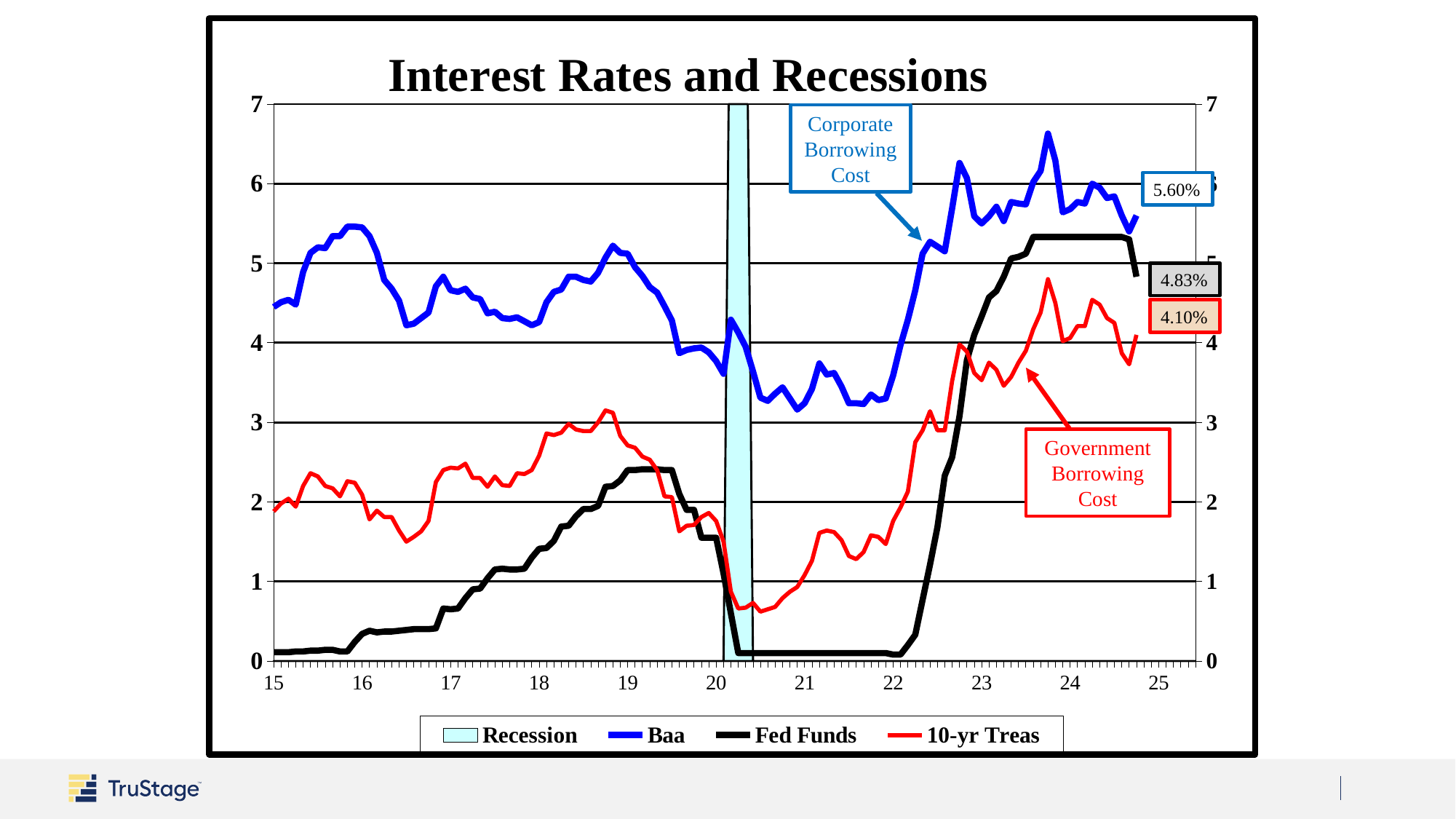
What is the title of the chart? Interest Rates and Recessions Is the Fed Funds value during 2021 greater or less than 1? less How many entries does the legend list? 4 Does the Fed Funds line rise or fall between 2022 and 2023? rise Which series has the lowest labelled value at the end of the chart? 10-yr Treas Which series has the highest labelled value at the end of the chart? Baa What is the latest labelled value for the Baa series? 5.60% What is the latest labelled value for the Fed Funds series? 4.83% What is the difference between the labelled Baa value (5.60%) and the labelled 10-yr Treas value (4.10%)? 1.50% What kind of chart is shown on the slide? line chart Which series does the 'Corporate Borrowing Cost' callout point to? Baa What is the latest labelled value for the 10-yr Treas series? 4.10%